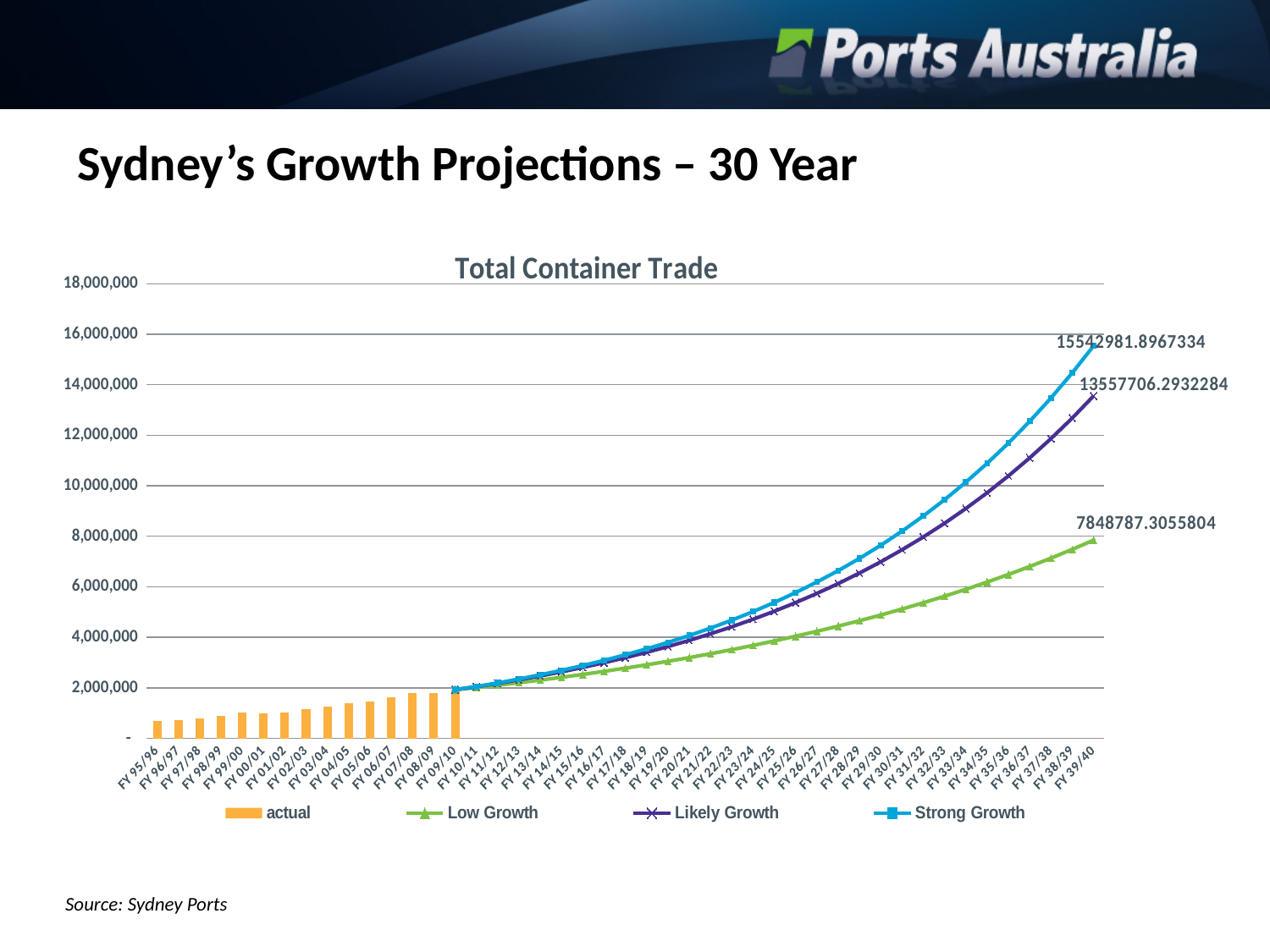
Is the actual value for FY 95/96 greater or less than 2,000,000? less What is the Low Growth value at FY 39/40? 7848787.3055804 Which growth scenario has the highest value at FY 39/40? Strong Growth What kind of chart is this? Combined bar and line chart Do the projected growth lines rise or fall from FY 10/11 to FY 39/40? Rise Which series is shown as orange bars in the legend? actual Which growth scenario has the lowest value at FY 39/40? Low Growth What is the difference between the Strong Growth and Likely Growth values at FY 39/40? 1985275.603505 What is the Likely Growth value at FY 39/40? 13557706.2932284 What is the Strong Growth value at FY 39/40? 15542981.8967334 What is the title of the chart? Total Container Trade How many series does the legend list? 4